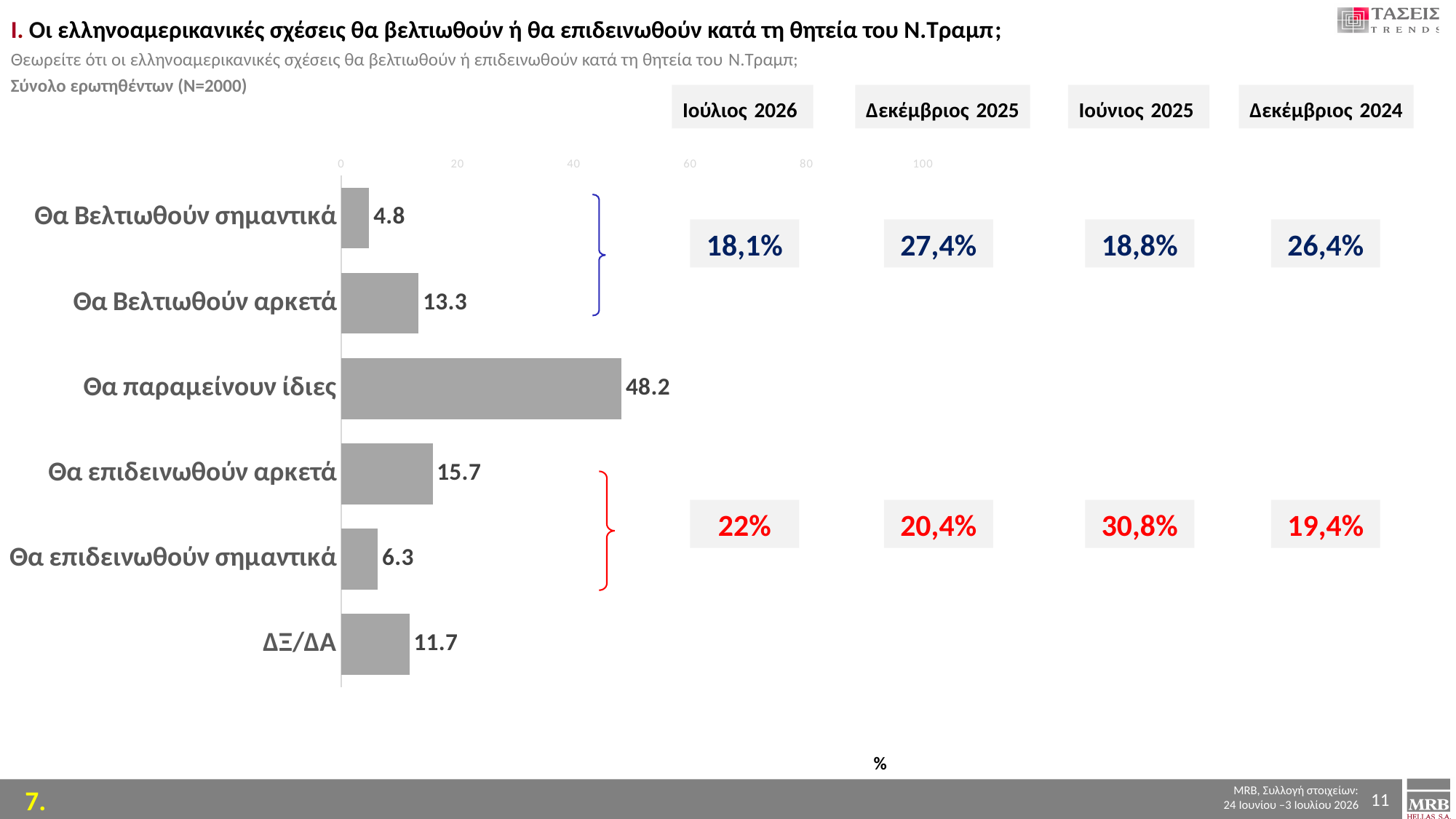
What value is shown for "Θα παραμείνουν ίδιες"? 48.2 What kind of chart is shown on the slide? bar chart How many categories are shown in the bar chart? 6 Which category has the lowest value in the bar chart? Θα Βελτιωθούν σημαντικά What is the difference between the values for "Θα επιδεινωθούν αρκετά" and "Θα Βελτιωθούν αρκετά"? 2.4 What value is shown for "Θα επιδεινωθούν αρκετά"? 15.7 What colour are the bars in the chart? grey Which is larger: the value for "Θα επιδεινωθούν σημαντικά" or the value for "Θα Βελτιωθούν σημαντικά"? Θα επιδεινωθούν σημαντικά Which category has the highest value in the bar chart? Θα παραμείνουν ίδιες What is the combined total of "Θα Βελτιωθούν σημαντικά" and "Θα Βελτιωθούν αρκετά"? 18.1 What value is shown for "ΔΞ/ΔΑ"? 11.7 Is the value for "Θα παραμείνουν ίδιες" greater or less than 40? greater